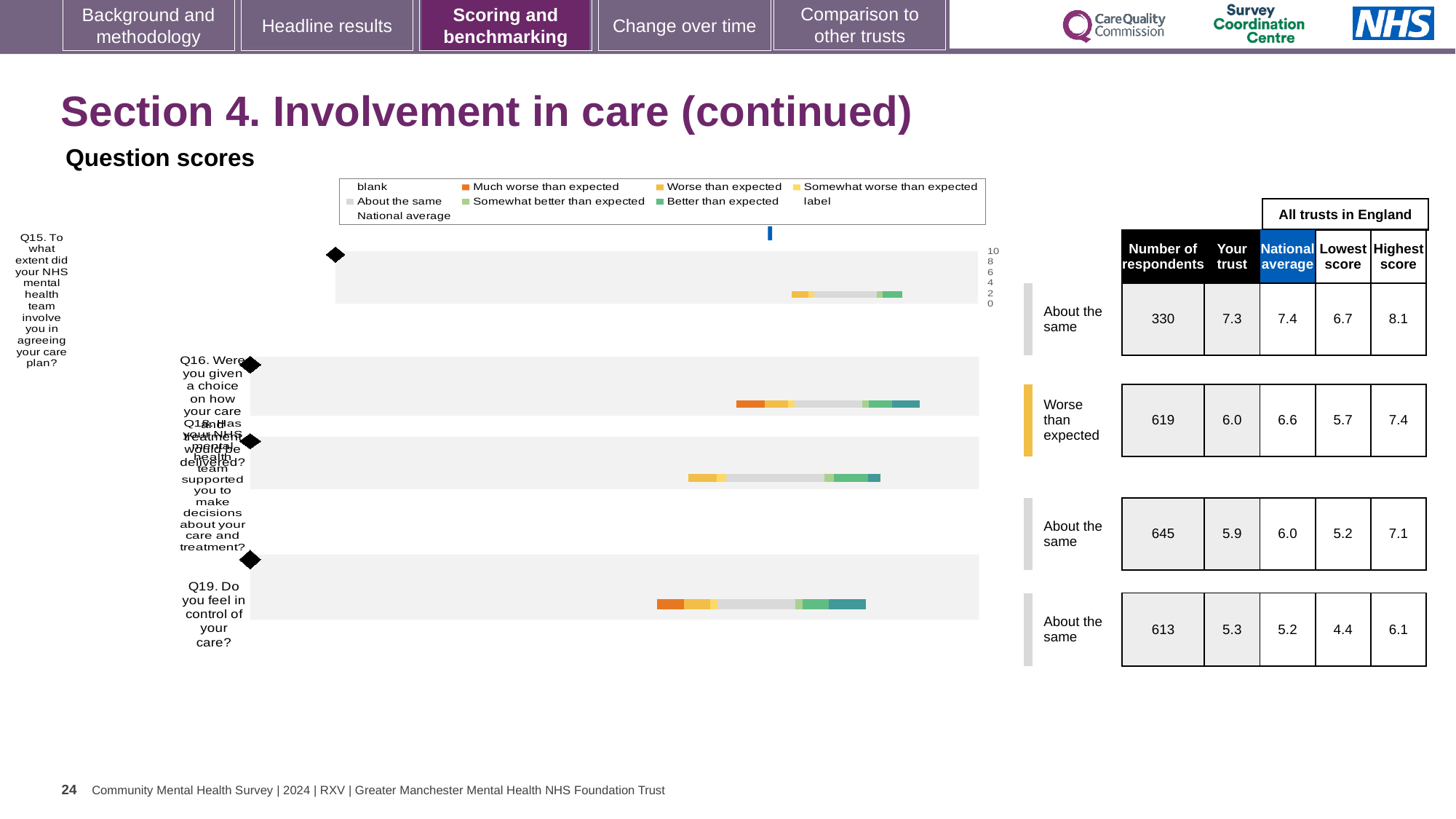
Which colour in the legend represents 'Much worse than expected'? orange In the table beside the chart, what is the difference between the highest score and the lowest score for Q18 (the third row)? 1.9 In the table beside the chart, what is the number of respondents for Q19 (the last row)? 613 In the table beside the chart, is the 'Your trust' score for Q16 higher or lower than the national average? lower What kind of chart is shown under 'Question scores'? bar chart Which benchmark category is shown for Q16 in the chart? Worse than expected In the table beside the chart, which row has the lowest 'Your trust' score? Q19 (5.3) In the table beside the chart, what is the 'Your trust' score for Q15 (the first row)? 7.3 How many survey questions (categories) are plotted in the chart? 4 In the table beside the chart, what is the national average for Q16 (the second row)? 6.6 Which legend entry is shown in teal/dark green? Better than expected In the table beside the chart, which row has the highest 'Your trust' score? Q15 (7.3)